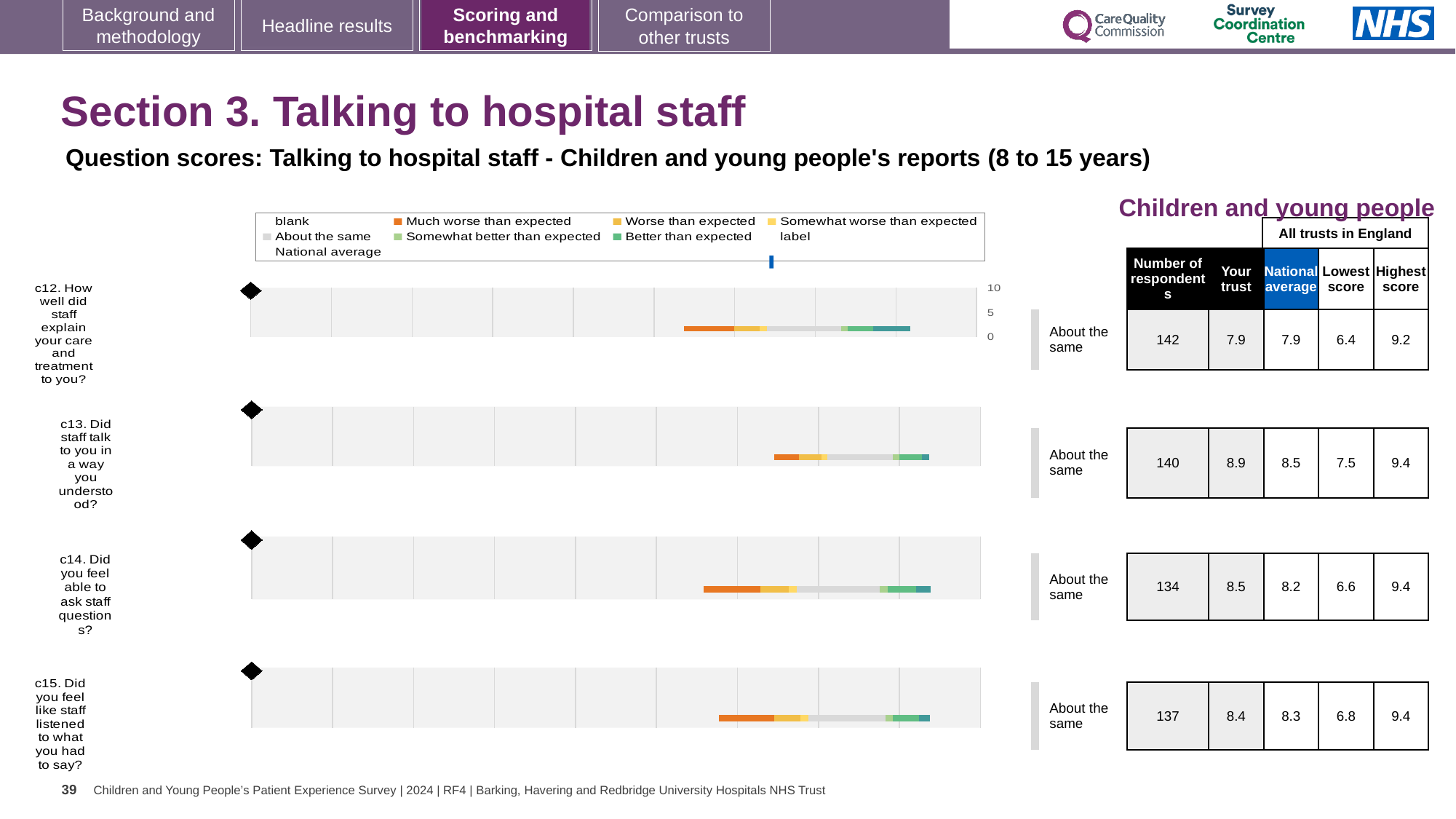
Which question has the highest 'Your trust' score? c13 What is the highest score among all trusts in England for c15 (Did you feel like staff listened to what you had to say?)? 9.4 What benchmark category is shown for c12? About the same What kind of chart is used to show the question scores for c12 to c15? bar chart How many respondents answered c14 (Did you feel able to ask staff questions?)? 134 For c13, how much higher is the 'Your trust' score than the national average? 0.4 In the chart legend, which colour represents 'Much worse than expected'? orange What is the national average score for c12 (How well did staff explain your care and treatment to you?)? 7.9 Which question has the lowest 'Your trust' score? c12 For c14, which is larger: the 'Your trust' score or the national average? Your trust What is the 'Your trust' score for c13 (Did staff talk to you in a way you understood?)? 8.9 How many survey questions (c12 to c15) are plotted on the slide? 4